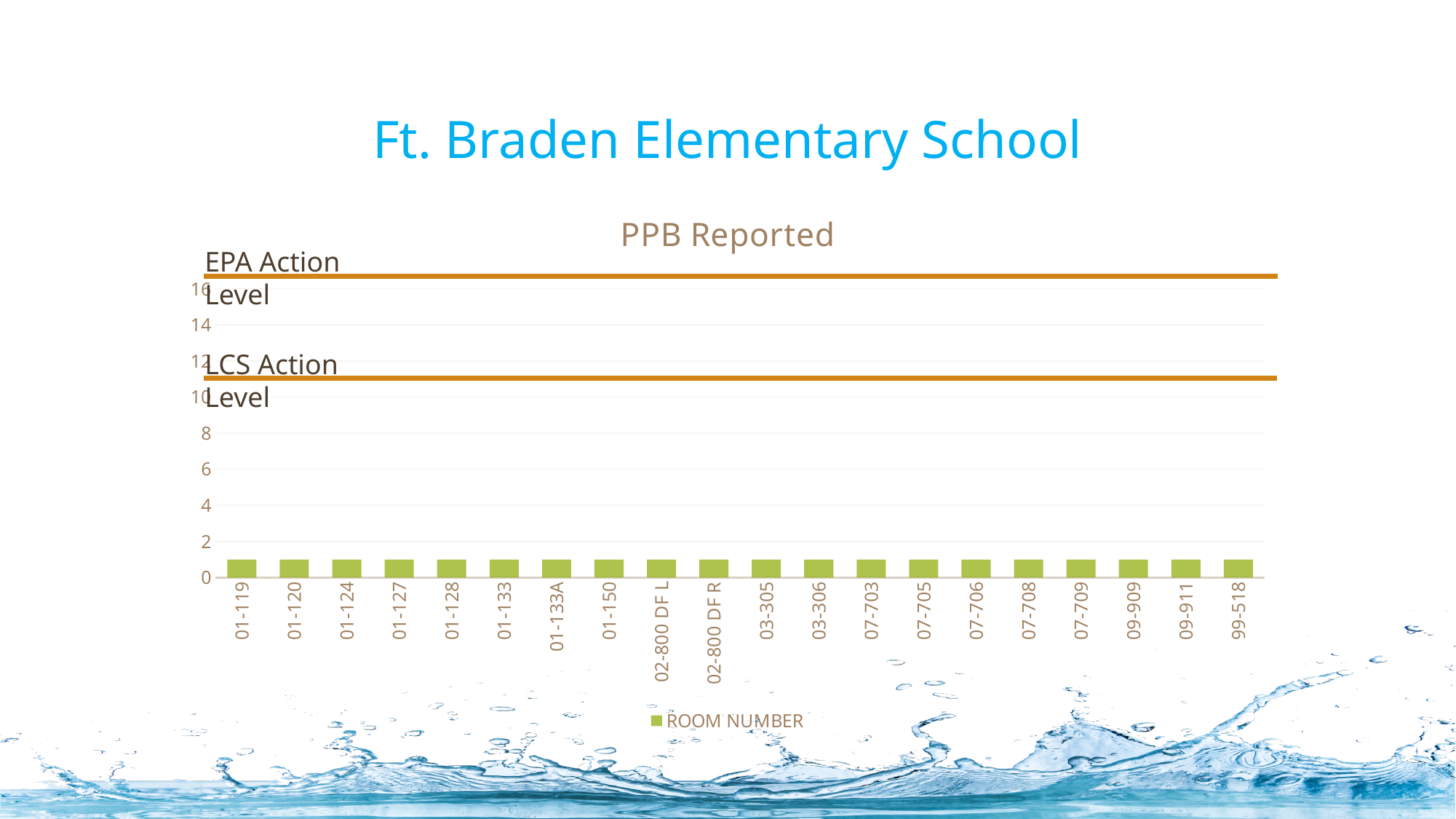
What kind of chart is shown on the slide? bar chart Is the value for 99-518 greater or less than 4? less Is the value for 07-705 greater or less than 10? less Is the value for 02-800 DF L greater or less than 6? less What is the title of the chart? PPB Reported What is the name of the series shown in the legend? ROOM NUMBER Do the bar values rise, fall, or stay flat from left to right along the x axis? stay flat How many room number categories are plotted along the x axis? 20 How many series does the legend list? 1